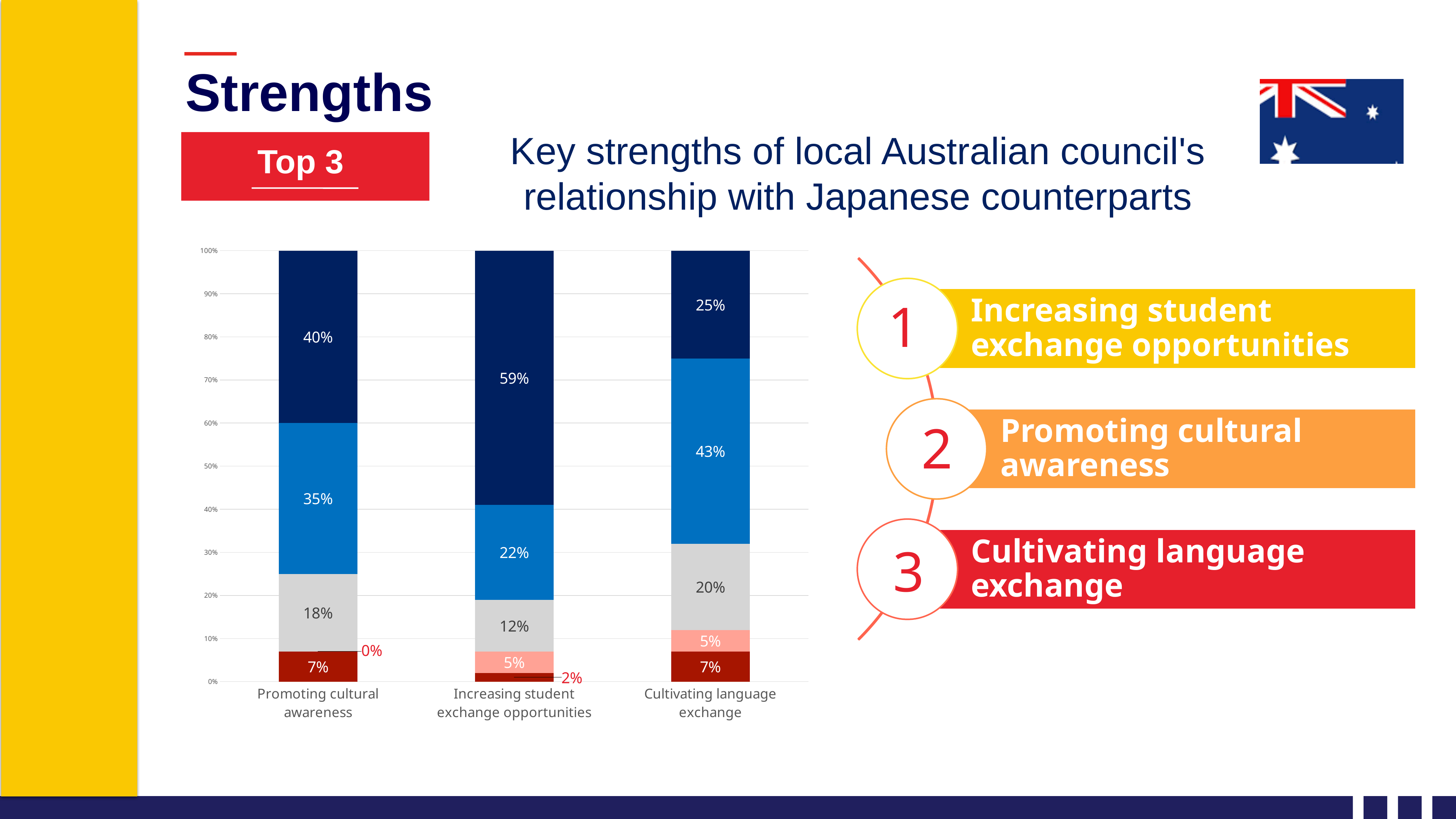
Which category has the smallest dark navy top segment? Cultivating language exchange What kind of chart is shown on the slide? stacked bar chart What is the value of the dark red bottom segment for Cultivating language exchange? 7% What is the value of the dark navy top segment for Increasing student exchange opportunities? 59% What is the value of the blue segment for Cultivating language exchange? 43% How many categories are shown on the x axis of the chart? 3 What is the value of the grey segment for Increasing student exchange opportunities? 12% What is the difference between the dark navy top segment for Increasing student exchange opportunities and for Promoting cultural awareness? 19% Which category has the largest dark navy top segment? Increasing student exchange opportunities Which is larger: the blue segment for Cultivating language exchange or the blue segment for Promoting cultural awareness? Cultivating language exchange What is the value of the dark navy top segment for Promoting cultural awareness? 40% What is the total of the stacked bar for Promoting cultural awareness? 100%